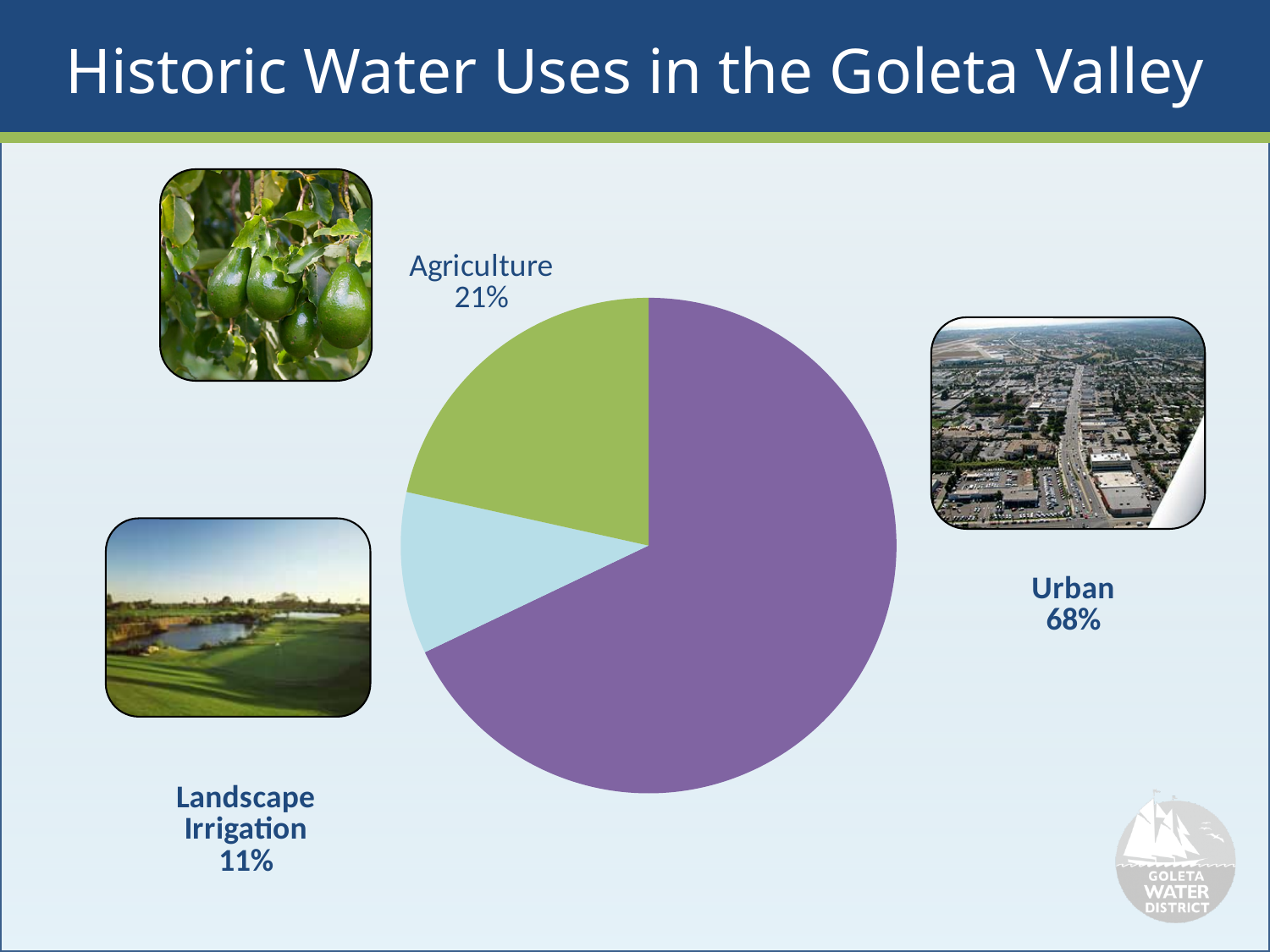
How many slices does the pie chart have? 3 Which water use category has the smallest share of the pie? Landscape Irrigation What is the difference in percentage points between the Urban and Agriculture shares? 47 What share of historic water use is Agriculture? 21% What is the difference in percentage points between the Agriculture and Landscape Irrigation shares? 10 What kind of chart is shown on the slide? pie chart What is the title of the slide containing the pie chart? Historic Water Uses in the Goleta Valley Which is larger, the Agriculture share or the Landscape Irrigation share? Agriculture What colour is the Urban slice of the pie chart? purple What share of historic water use in the Goleta Valley is Urban? 68% What share of historic water use is Landscape Irrigation? 11% Which water use category has the largest share of the pie? Urban